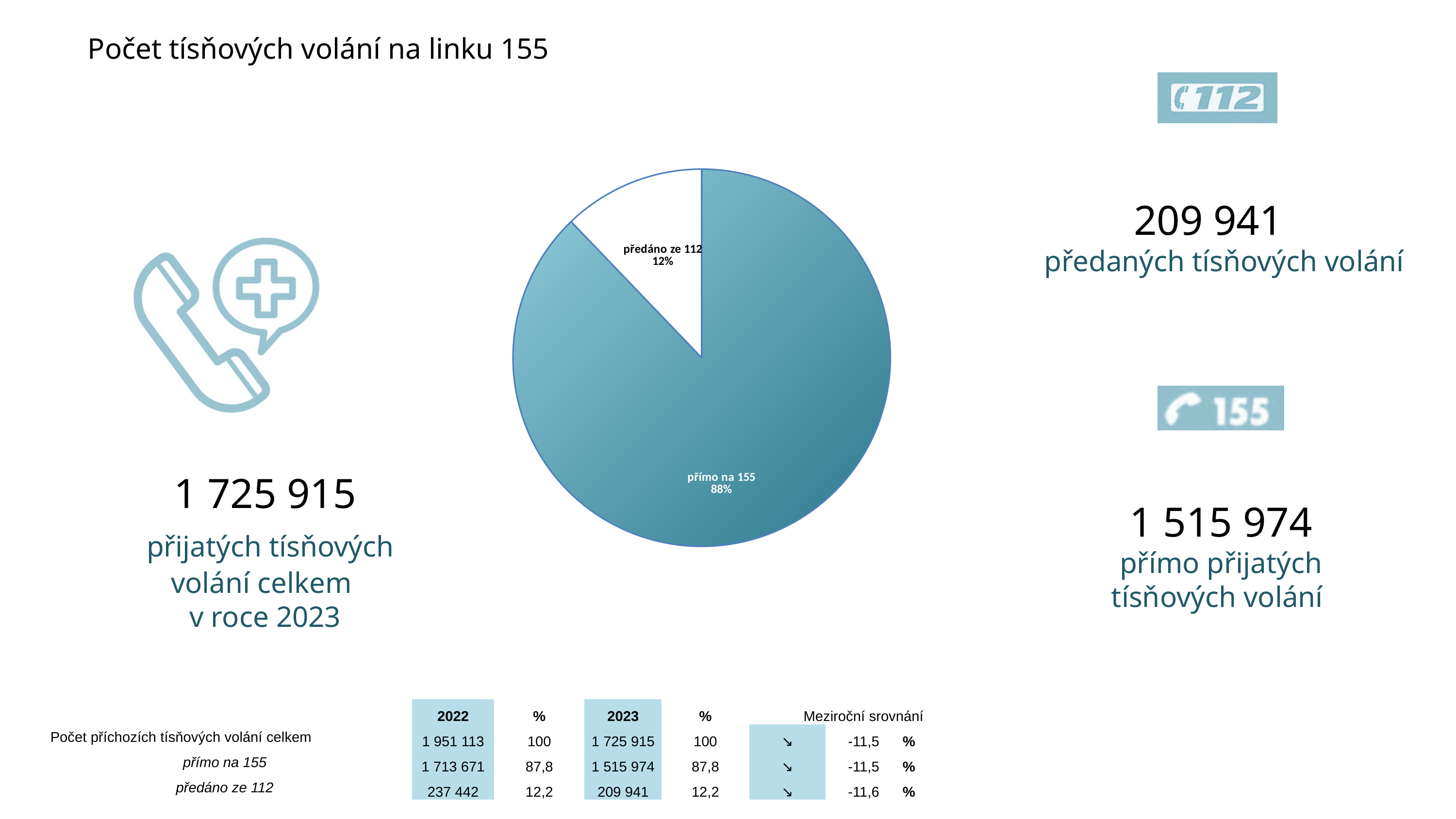
What kind of chart is shown on the slide? pie chart What is the difference in percentage points between the "přímo na 155" and "předáno ze 112" slices of the pie chart? 76 What is the title of the slide containing the pie chart? Počet tísňových volání na linku 155 Which slice of the pie chart is the smallest? předáno ze 112 Which slice of the pie chart is the largest? přímo na 155 What share of the pie chart is labelled "předáno ze 112"? 12% Is the share of the "předáno ze 112" slice in the pie chart greater or less than 50%? less How many slices does the pie chart have? 2 Which slice of the pie chart is shown in white? předáno ze 112 In the pie chart, which is larger: "přímo na 155" or "předáno ze 112"? přímo na 155 What share of the pie chart is labelled "přímo na 155"? 88%